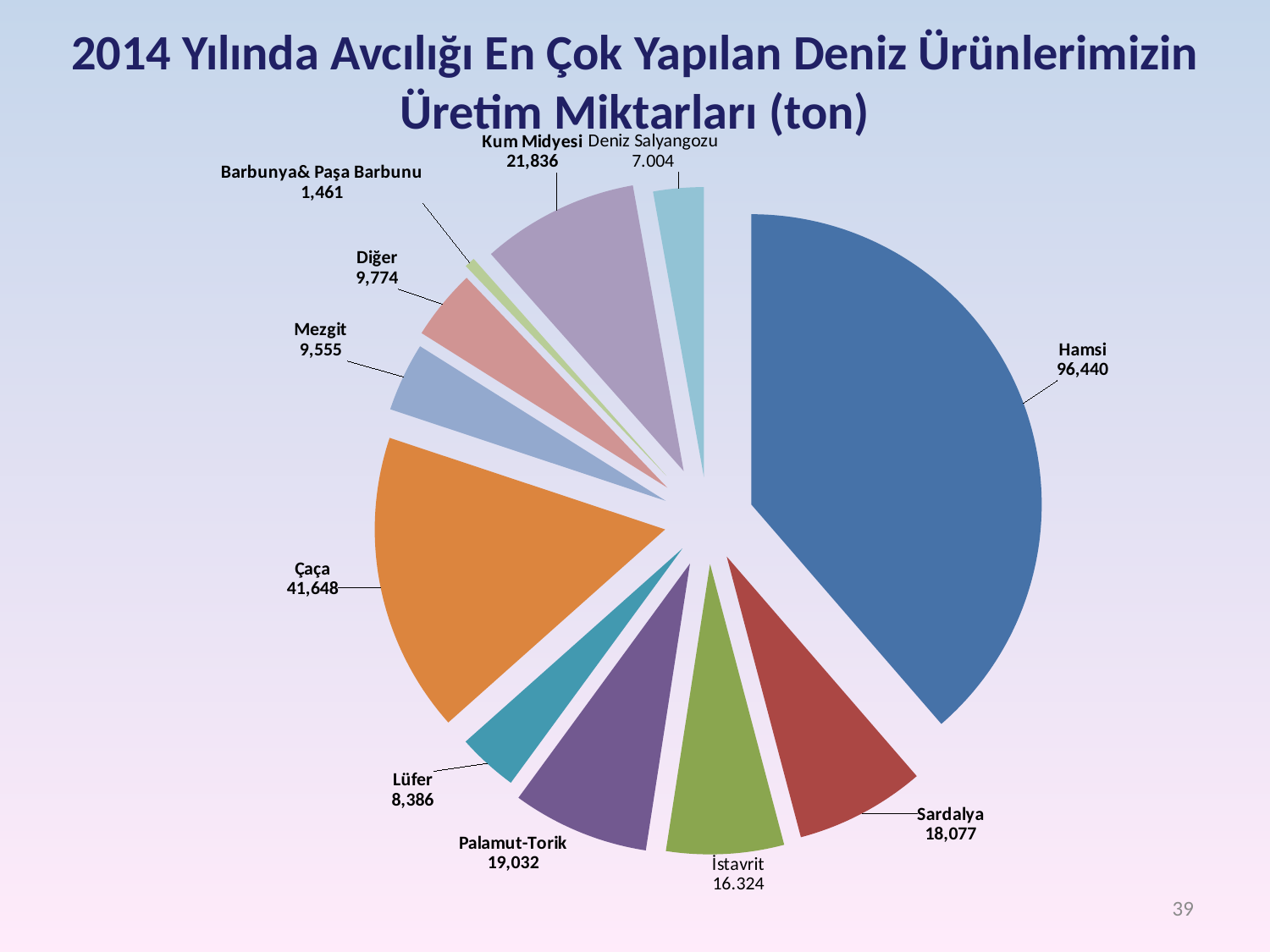
Which category has the smallest slice of the pie? Barbunya& Paşa Barbunu What is the difference between the values for Palamut-Torik and Sardalya? 955 What is the production amount for Kum Midyesi? 21,836 How many categories (slices) does the pie chart have? 11 What is the production amount for Çaça? 41,648 What is the production amount for Lüfer? 8,386 What is the production amount for Hamsi? 96,440 What value is shown for Deniz Salyangozu? 7.004 Which is larger, the value for Çaça or the value for Kum Midyesi? Çaça What type of chart is shown on the slide? pie chart Which category has the largest slice of the pie? Hamsi What is the difference between the values for Hamsi and Çaça? 54,792